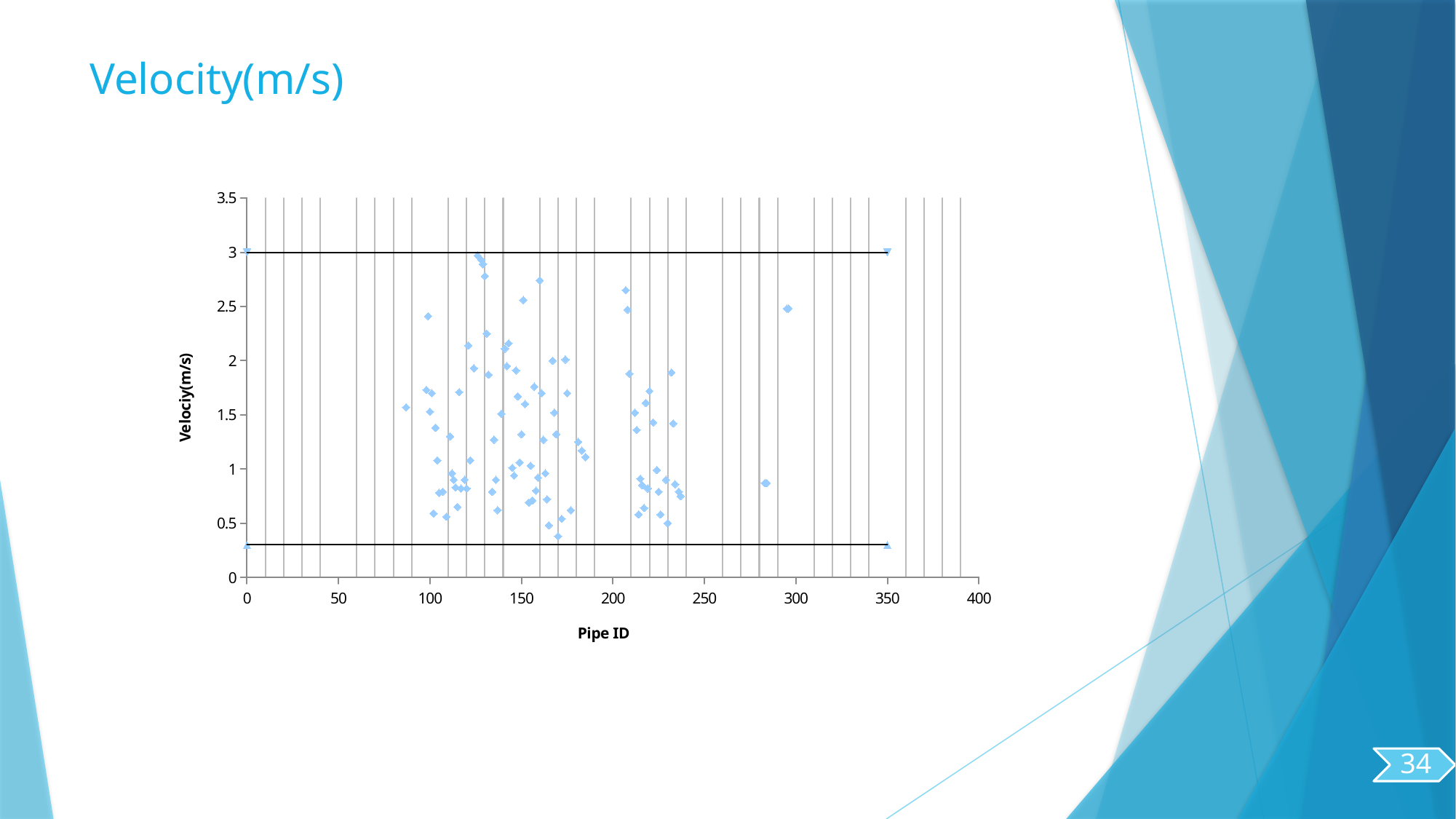
Is the velocity of the point plotted near Pipe ID 295 greater or less than 2? greater Is the lower horizontal line greater or less than 0.5 on the y axis? less What is the title of the chart's x axis? Pipe ID At what y-axis value does the upper horizontal line sit? 3 Is the velocity of the point plotted near Pipe ID 283 greater or less than 1? less What is the maximum value shown on the y axis? 3.5 What kind of chart is shown on the slide? scatter chart What is the title of the chart's y axis? Velociy(m/s)